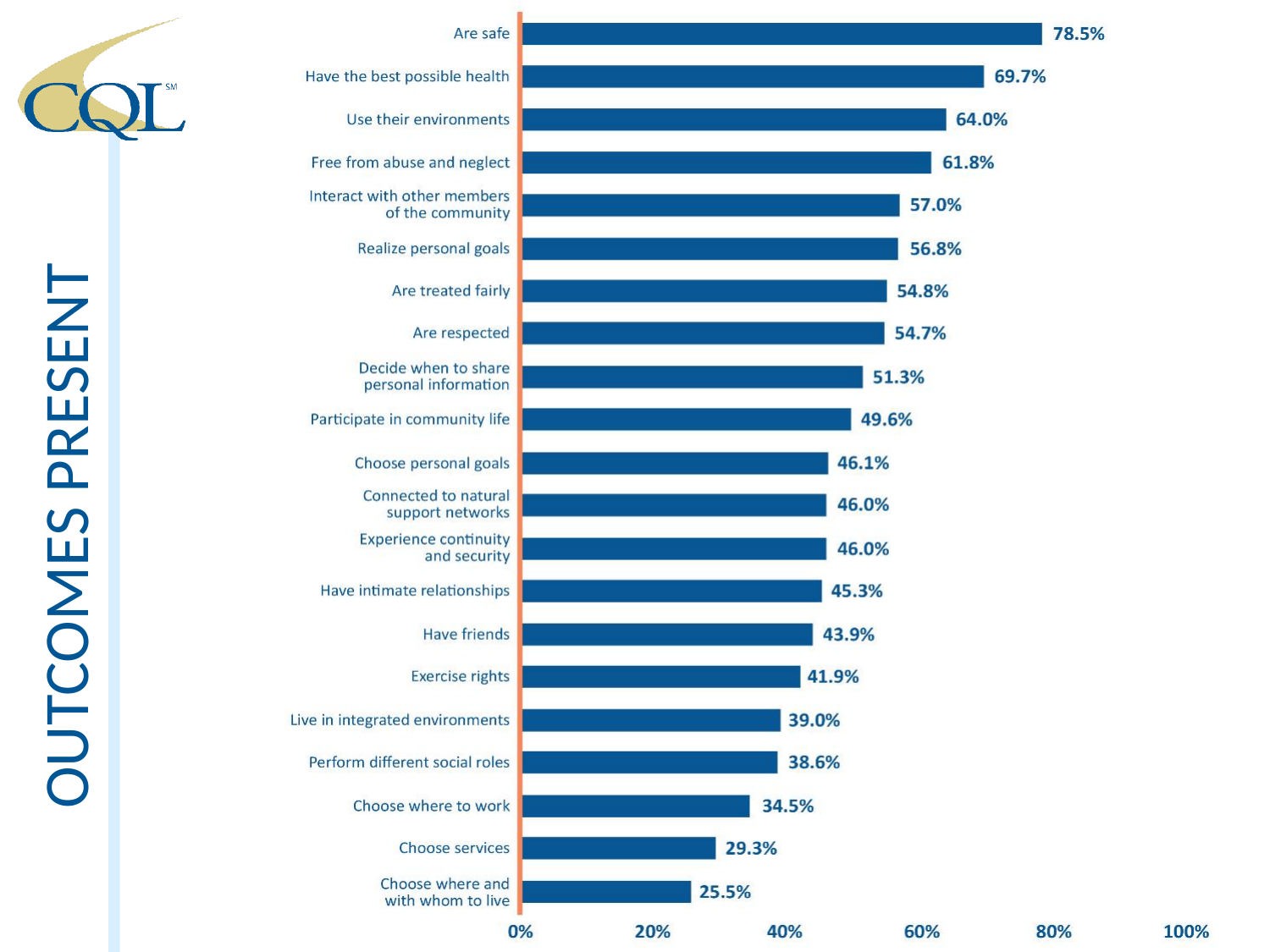
What is the difference between the values for "Have the best possible health" and "Use their environments"? 5.7% How many categories are shown in the chart? 21 What is the title shown on the slide? OUTCOMES PRESENT What is the value for "Have friends"? 43.9% Which category has the lowest value? Choose where and with whom to live What is the value for "Are safe"? 78.5% Is the value for "Free from abuse and neglect" greater or less than 60%? greater What is the value for "Choose where to work"? 34.5% What kind of chart is shown on the slide? bar chart Which is larger, the value for "Exercise rights" or the value for "Live in integrated environments"? Exercise rights What is the difference between the values for "Are safe" and "Choose where and with whom to live"? 53.0% Which category has the highest value? Are safe